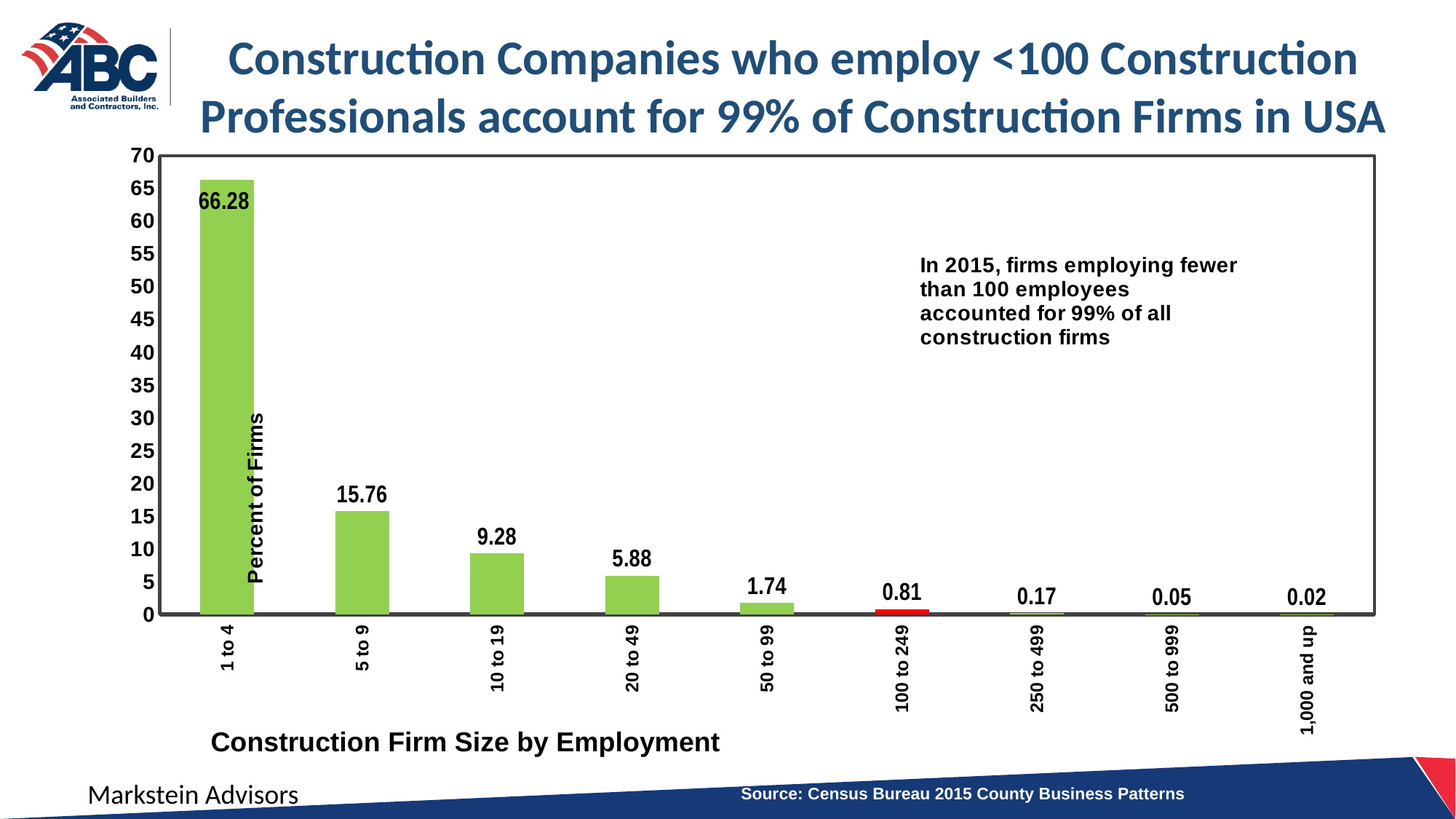
What is the percent of firms for the 1 to 4 employment size category? 66.28 What is the percent of firms for the 5 to 9 employment size category? 15.76 How many firm size categories are shown on the x axis? 9 Which firm size category has the highest percent of firms? 1 to 4 Which firm size category has the lowest percent of firms? 1,000 and up Do the values rise or fall as firm size increases along the x axis? fall What is the difference between the percent of firms for 10 to 19 and 20 to 49? 3.4 Which has a larger percent of firms, 50 to 99 or 250 to 499? 50 to 99 Is the value for 5 to 9 greater or less than 20? less What is the percent of firms for the 100 to 249 employment size category? 0.81 Which bar is coloured red rather than green? 100 to 249 What kind of chart is shown on the slide? bar chart